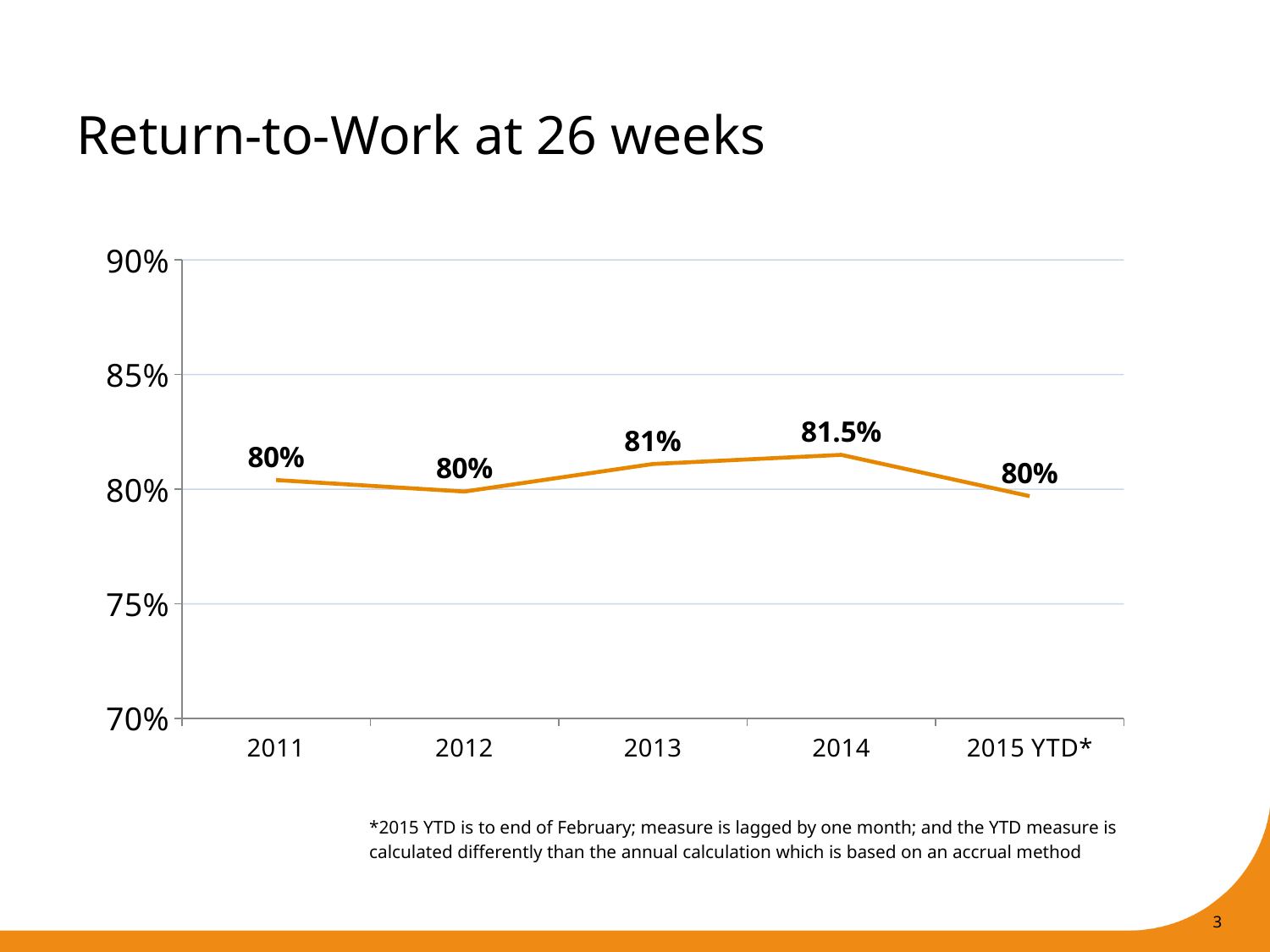
Which is larger, the value for 2013 or the value for 2014? 2014 What is the title of the chart? Return-to-Work at 26 weeks Is the value for 2014 greater or less than 85%? less What value is shown for 2015 YTD*? 80% What is the value plotted for 2013? 81% What is the value shown for 2011? 80% What kind of chart is shown on the slide? line chart Which year has the highest return-to-work rate? 2014 Does the line rise or fall from 2012 to 2014? rise What is the difference between the 2014 value and the 2013 value? 0.5% What is the return-to-work rate shown for 2014? 81.5% How many data points are plotted on the line? 5